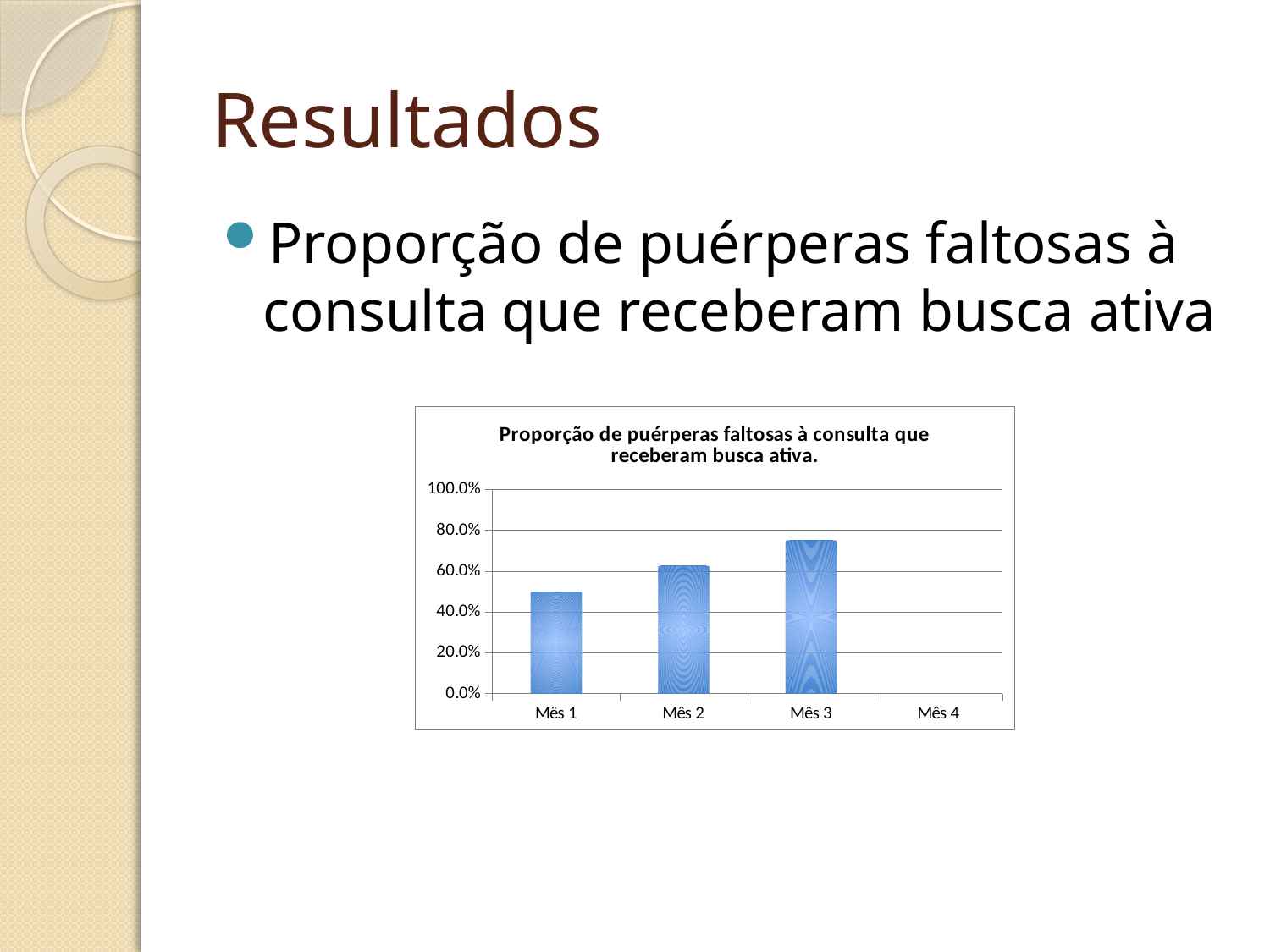
Is the value for Mês 2 greater or less than 40%? greater Which month on the x axis has no bar shown? Mês 4 Is the value for Mês 3 greater or less than 60%? greater Is the value for Mês 1 greater or less than 40%? greater Do the values rise or fall from Mês 1 to Mês 3? rise How many categories are shown on the x axis of the chart? 4 Which month has the highest bar in the chart? Mês 3 Which is larger, the value for Mês 1 or the value for Mês 3? Mês 3 What kind of chart is shown on the slide? Bar chart What is the title of the chart? Proporção de puérperas faltosas à consulta que receberam busca ativa.